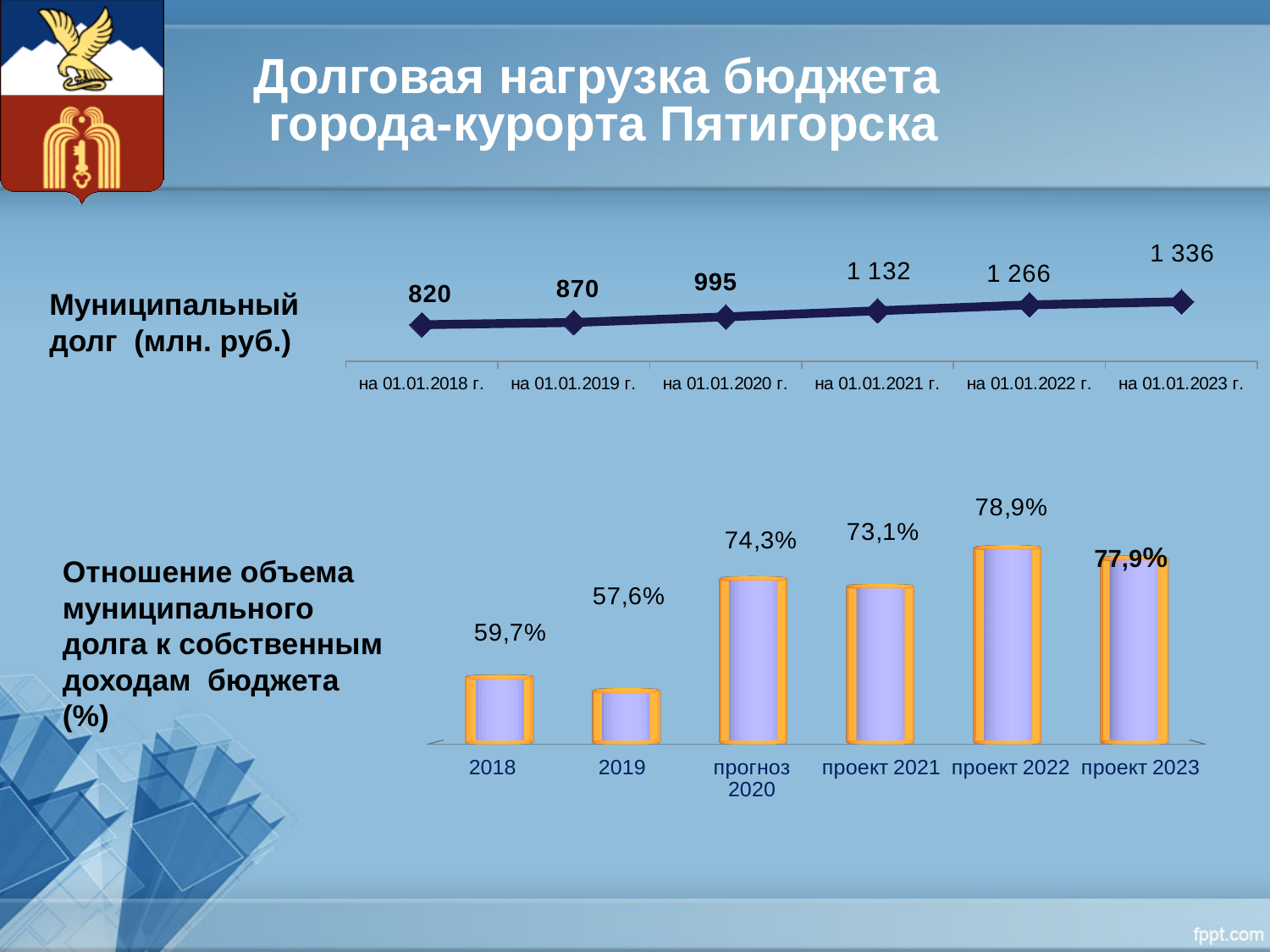
In the top chart (Муниципальный долг), do the values rise or fall from left to right? rise In the top chart (Муниципальный долг), how many data points are plotted? 6 In the bottom chart (Отношение объема муниципального долга к собственным доходам бюджета), which is larger: the value for прогноз 2020 or проект 2021? прогноз 2020 In the bottom chart (Отношение объема муниципального долга к собственным доходам бюджета), what is the value for проект 2022? 78,9% In the top chart (Муниципальный долг), which date has the lowest value? на 01.01.2018 г. What type of chart is the bottom chart (Отношение объема муниципального долга к собственным доходам бюджета)? bar chart What type of chart is the top chart (Муниципальный долг)? line chart In the bottom chart (Отношение объема муниципального долга к собственным доходам бюджета), which category has the highest value? проект 2022 In the top chart (Муниципальный долг), what is the value on 01.01.2020? 995 In the bottom chart (Отношение объема муниципального долга к собственным доходам бюджета), what is the value for 2019? 57,6% In the top chart (Муниципальный долг), what is the difference between the values on 01.01.2022 and 01.01.2021? 134 In the top chart (Муниципальный долг), what is the value on 01.01.2023? 1 336